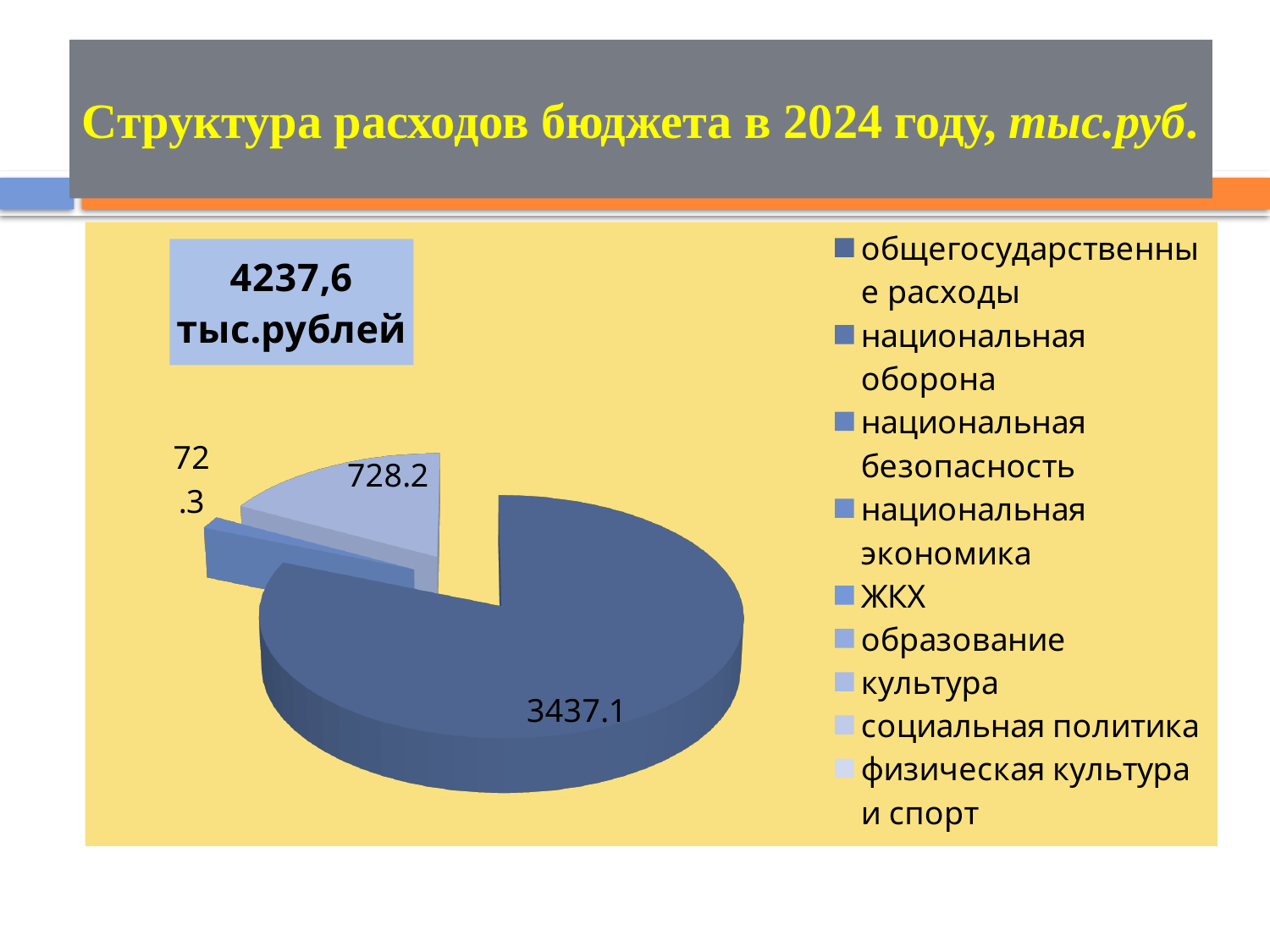
What is the title of the chart on the slide? 4237,6 тыс.рублей What value is printed on the light-coloured exploded slice of the pie chart? 728.2 What is the value of the smallest labelled slice of the pie chart? 72.3 What is the difference between the slice labelled 3437.1 and the slice labelled 728.2? 2708.9 Which is larger: the slice labelled 728.2 or the slice labelled 72.3? 728.2 What kind of chart is shown on the slide? pie chart What is the value of the largest slice of the pie chart? 3437.1 Which legend category does the largest (dark blue) slice of the pie chart represent? общегосударственные расходы How many slices of the pie chart have a printed data label? 3 What total amount in thousand rubles is shown in the box above the pie chart? 4237,6 тыс.рублей How many entries does the chart legend list? 9 What is the difference between the slice labelled 728.2 and the slice labelled 72.3? 655.9